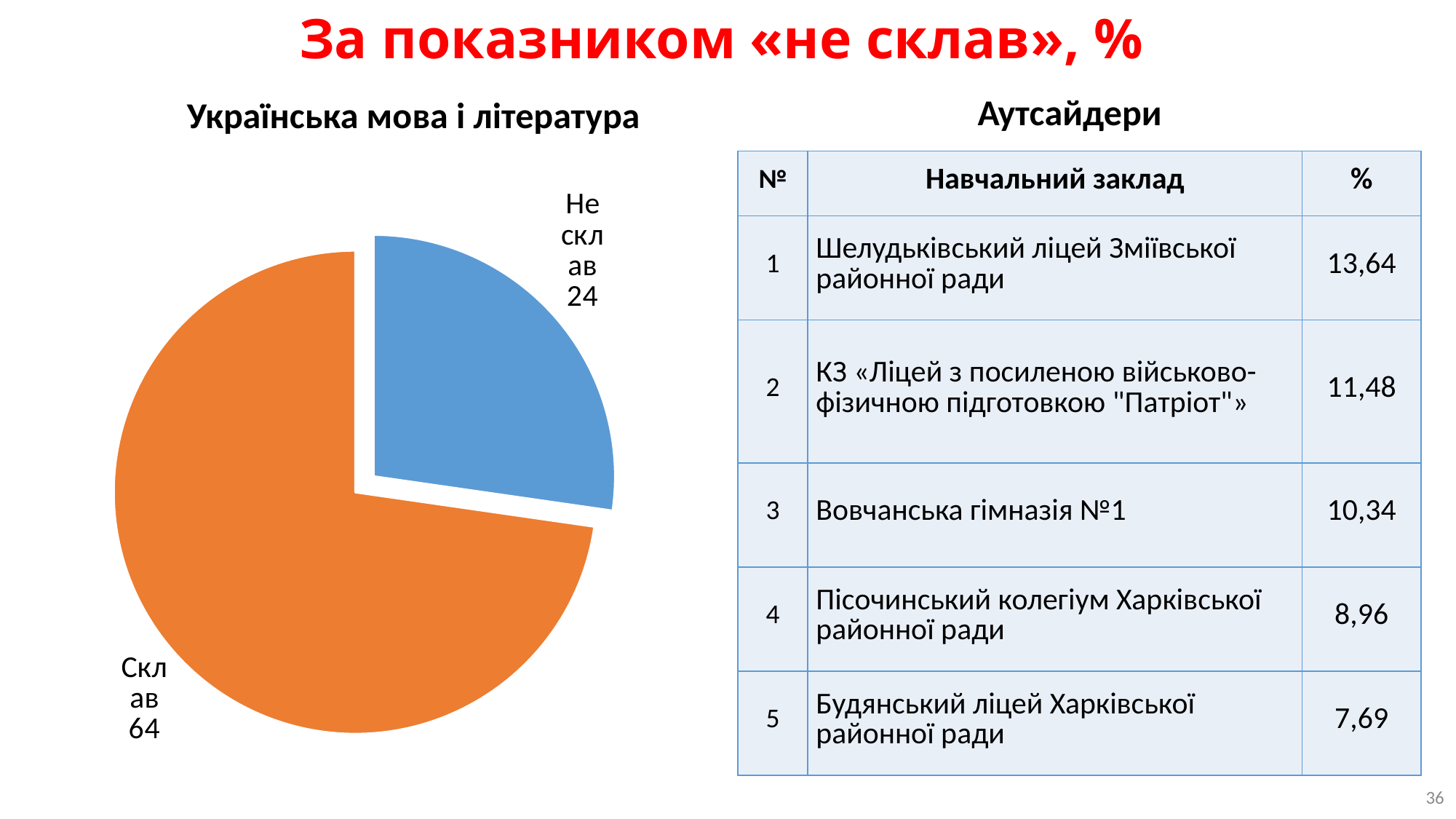
What kind of chart is shown under the title "Українська мова і література"? pie chart In the pie chart, what value is shown for "Не склав"? 24 Which slice of the pie chart is the largest? Склав In the pie chart, which is larger: "Склав" or "Не склав"? Склав Which slice of the pie chart is the smallest? Не склав In the pie chart, what value is shown for "Склав"? 64 What colour is the "Не склав" slice in the pie chart? blue How many slices does the pie chart have? 2 What is the difference between the "Склав" and "Не склав" values in the pie chart? 40 What is the title of the pie chart on the left of the slide? Українська мова і література